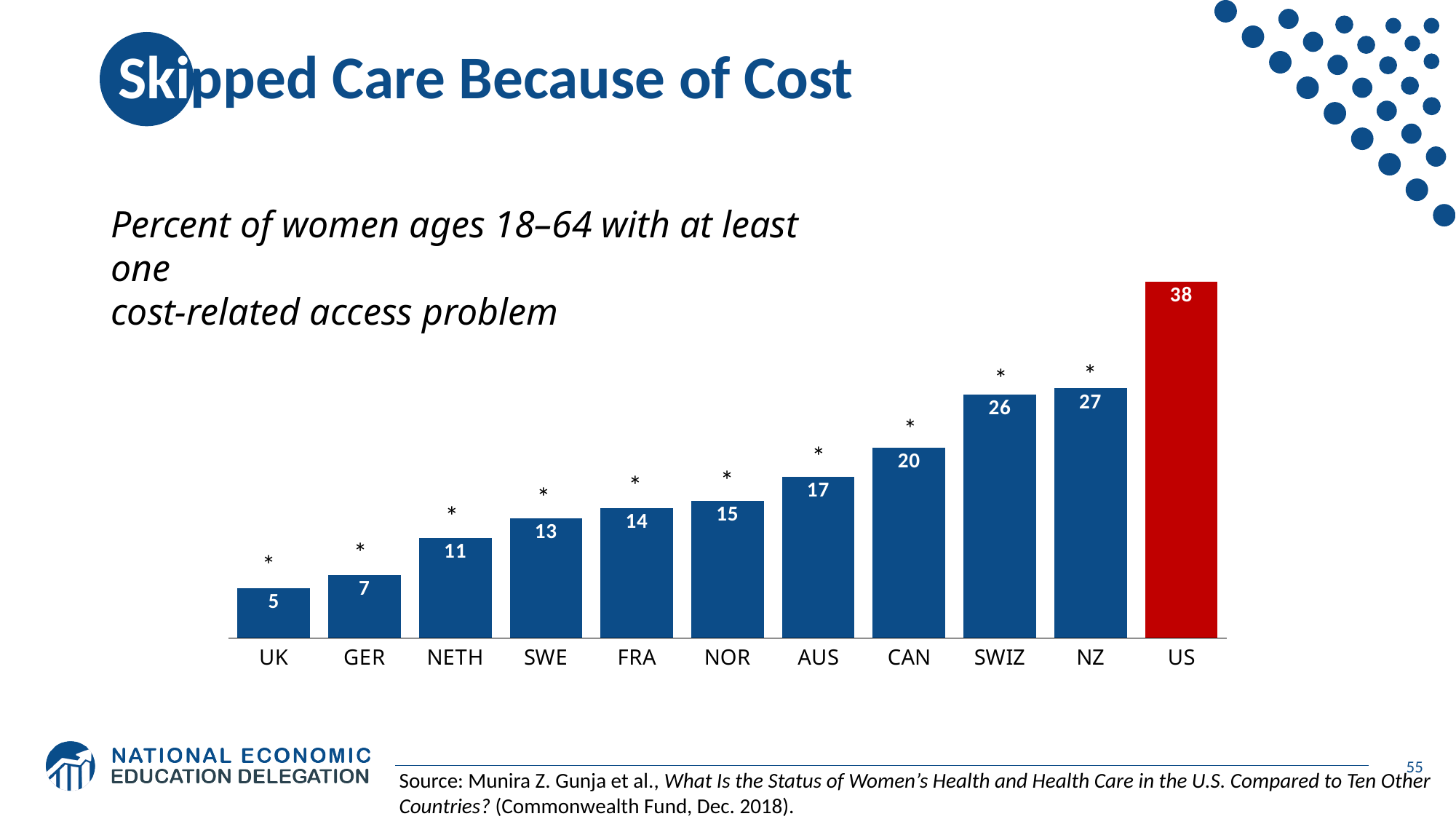
Which country has the lowest value? UK Which bar is coloured red rather than blue? US Which country has the highest value? US What kind of chart is shown on the slide? Bar chart What is the difference between the values for the US and NZ? 11 Do the values rise or fall from left to right across the countries? Rise Which has a larger value, AUS or FRA? AUS How many countries are shown on the chart? 11 What is the value for NETH? 11 What is the difference between the values for SWIZ and GER? 19 What is the value for CAN? 20 What is the value for the US? 38